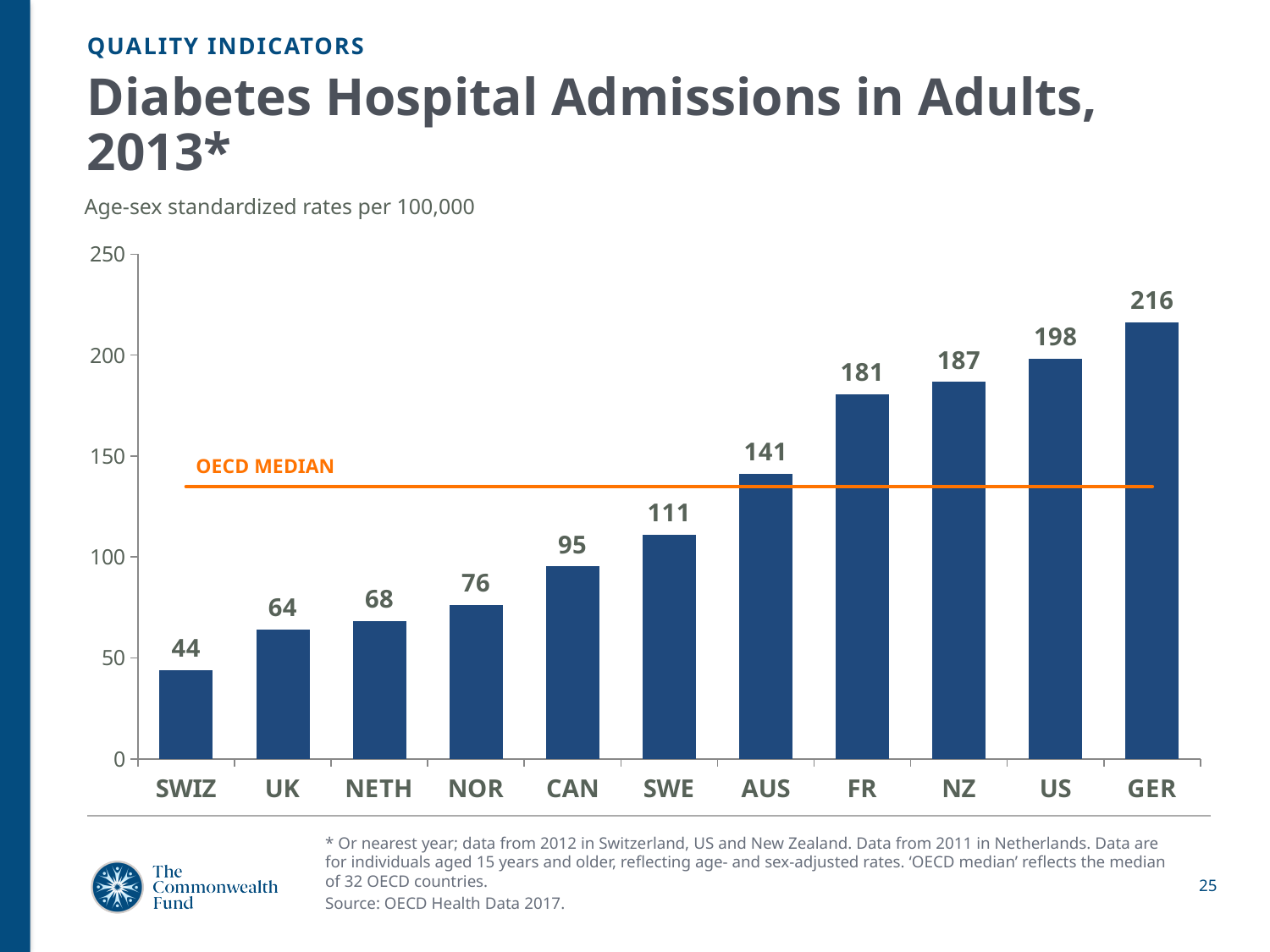
Which has a higher value, Sweden (SWE) or Australia (AUS)? AUS What does the orange horizontal line on the chart represent? OECD median What is the difference between the values for New Zealand (NZ) and France (FR)? 6 Which country has the highest diabetes hospital admission rate? GER What kind of chart is shown on the slide? Bar chart Which country has the lowest diabetes hospital admission rate? SWIZ What is the diabetes hospital admission rate for Canada (CAN)? 95 How many countries are shown in the chart? 11 Is the value for the UK greater or less than 50? greater What is the difference between the values for Germany (GER) and Switzerland (SWIZ)? 172 Do the values rise or fall from left to right across the countries? Rise What is the value shown for the US? 198